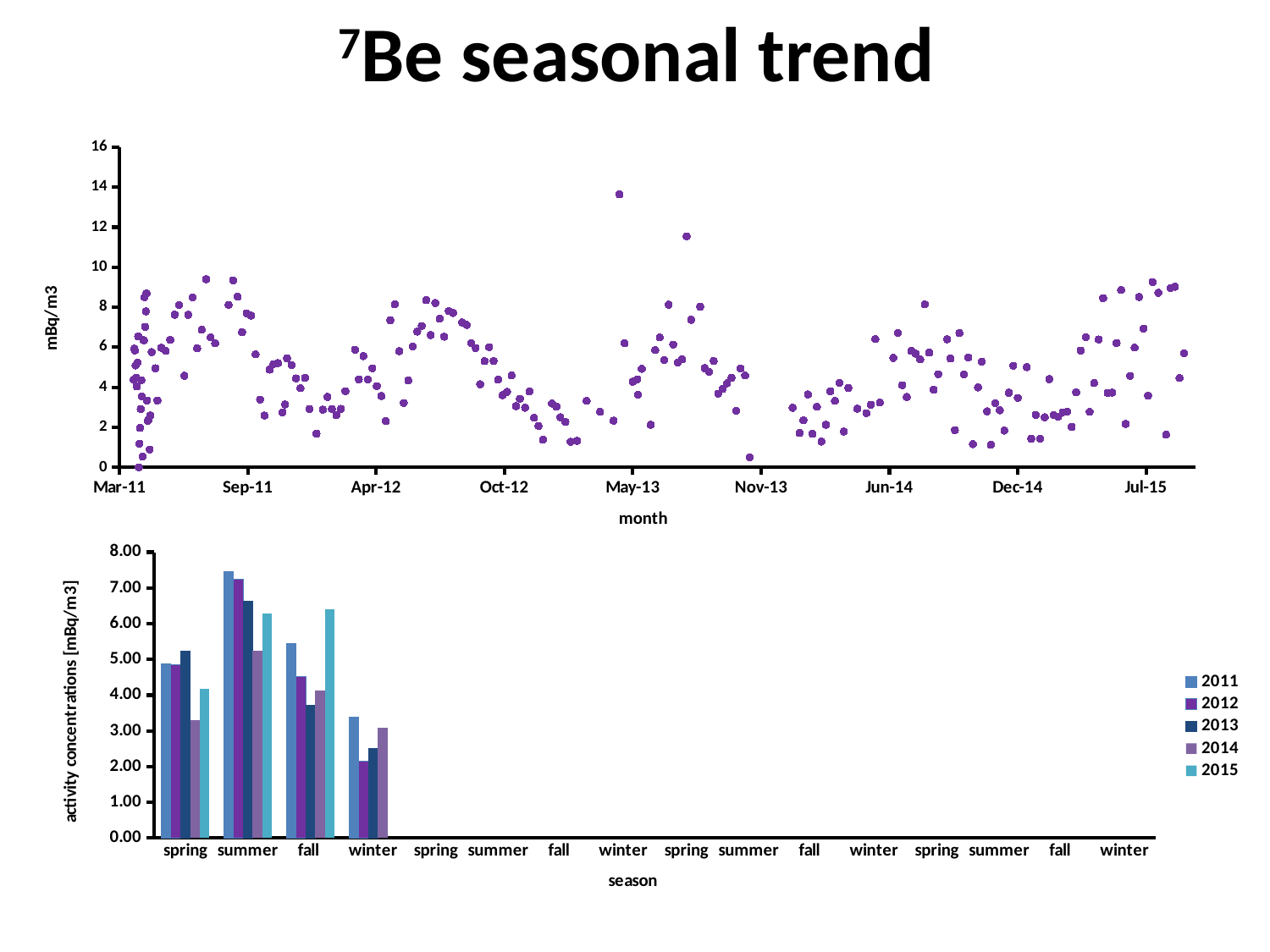
What is the x-axis title of the top chart? month In the bottom chart, which is larger in summer: the value for 2011 or the value for 2014? 2011 In the bottom chart, is the value for 2011 in summer greater or less than 7.00? greater What kind of chart is the bottom chart on the slide? bar chart In the top chart, is the highest plotted point greater or less than 12? greater In the bottom chart, which season has the highest value for 2011? summer In the bottom chart, is the value for 2015 in fall greater or less than 6.00? greater In the bottom chart, which is larger in winter: the value for 2012 or the value for 2013? 2013 In the bottom chart, which season has the lowest value for 2012? winter What kind of chart is the top chart on the slide? scatter chart In the bottom chart, how many series does the legend list? 5